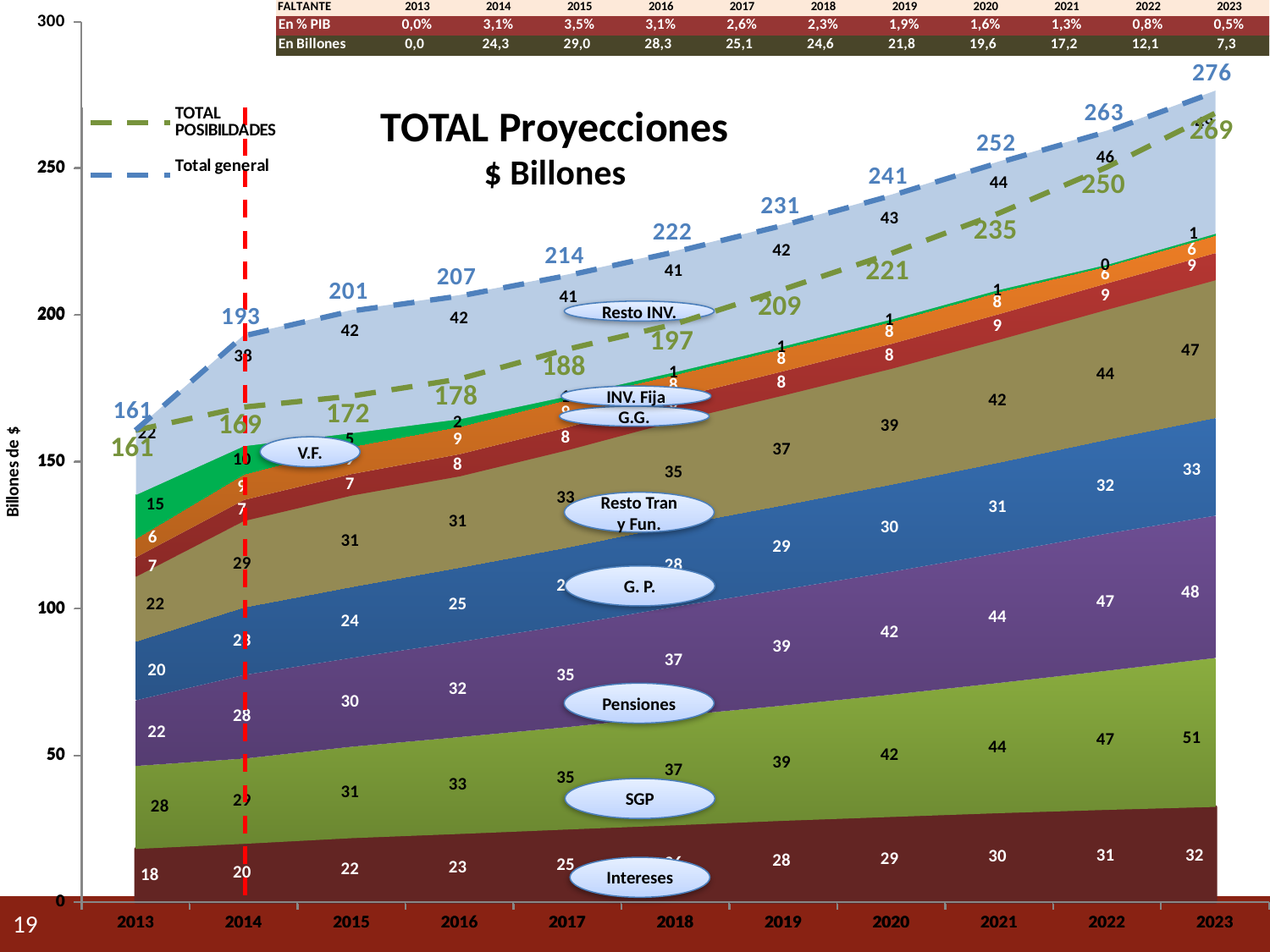
What kind of chart is shown on the slide? stacked area chart What is the Total general value for 2023? 276 How many years are shown on the x axis? 11 In which year is the Total general value highest? 2023 What is the SGP value for 2023? 51 What is the TOTAL POSIBILDADES value for 2023? 269 What is the Intereses value for 2013? 18 What is the difference between Total general and TOTAL POSIBILDADES in 2014? 24 In 2023, which is larger, SGP or Pensiones? SGP What is the Pensiones value for 2020? 42 What is the difference between the Total general values for 2023 and 2013? 115 Does the Total general line rise or fall from 2013 to 2023? rises